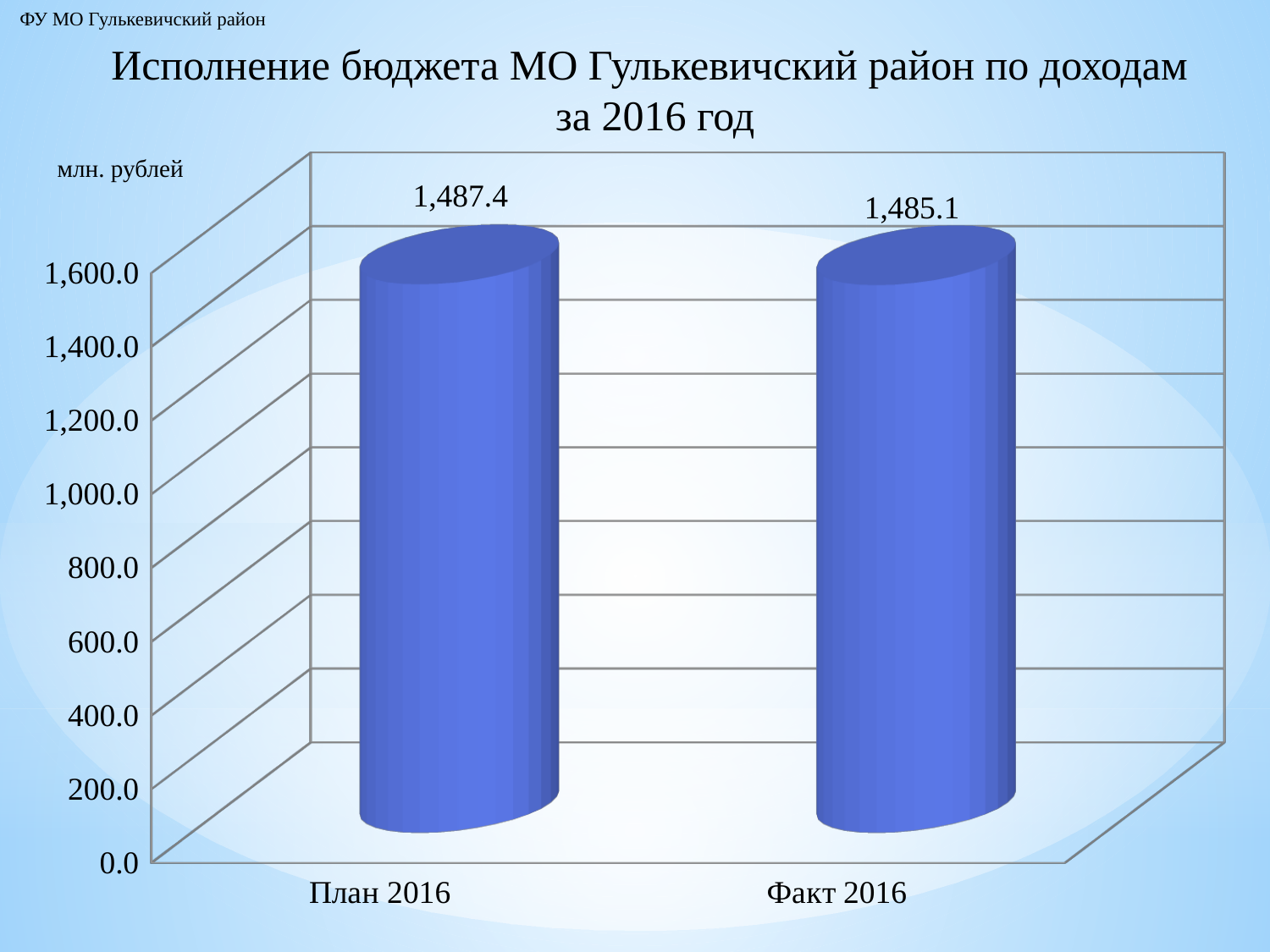
Is the value for Факт 2016 greater or less than 1,400.0? greater Is the value for План 2016 greater or less than 1,600.0? less What is the title of the chart? Исполнение бюджета МО Гулькевичский район по доходам за 2016 год What kind of chart is shown on the slide? bar chart What is the value for Факт 2016? 1,485.1 What unit of measurement is indicated for the chart values? млн. рублей How many categories are shown on the chart? 2 Which category has the higher value, План 2016 or Факт 2016? План 2016 What is the value for План 2016? 1,487.4 Which category has the lowest value? Факт 2016 What is the difference between the values for План 2016 and Факт 2016? 2.3